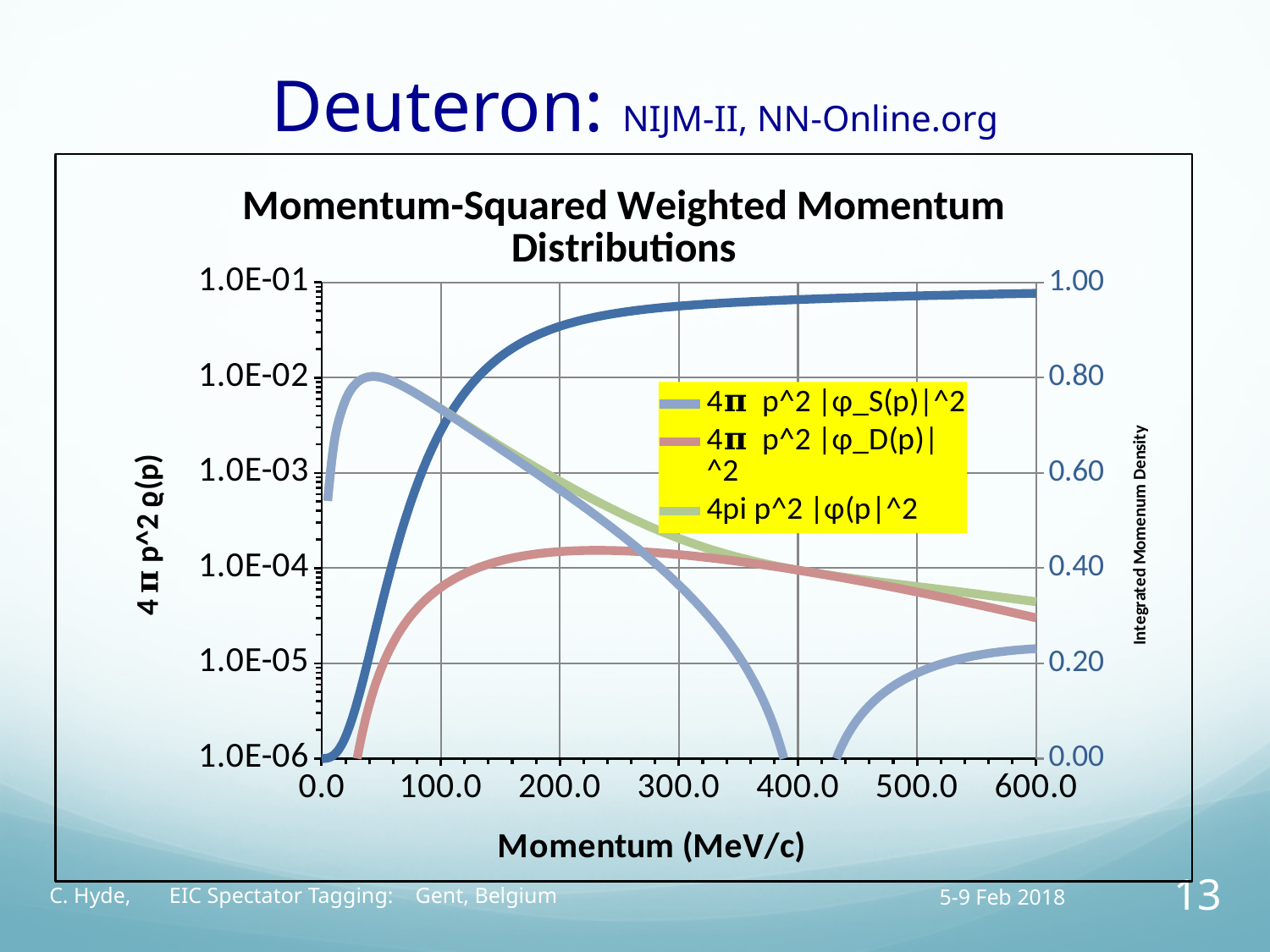
What kind of chart is shown on the slide? line chart What is the title of the chart? Momentum-Squared Weighted Momentum Distributions Does the dark blue integrated momentum density curve rise or fall as momentum increases? rise At 600.0 MeV/c, is the red 4π p^2 |φ_D(p)|^2 curve greater or less than 1.0E-04 on the left-hand axis? less At 100.0 MeV/c, which is larger: the 4π p^2 |φ_S(p)|^2 curve or the 4π p^2 |φ_D(p)|^2 curve? 4π p^2 |φ_S(p)|^2 What is the lowest value shown on the left-hand axis? 1.0E-06 How many tick labels are shown along the x axis? 7 What is the highest value shown on the right-hand axis? 1.00 What is the label of the x axis? Momentum (MeV/c) At 300.0 MeV/c, is the dark blue integrated momentum density curve greater or less than 0.80 on the right-hand axis? greater At 100.0 MeV/c, is the light blue 4π p^2 |φ_S(p)|^2 curve greater or less than 1.0E-03 on the left-hand axis? greater How many series does the chart's legend list? 3